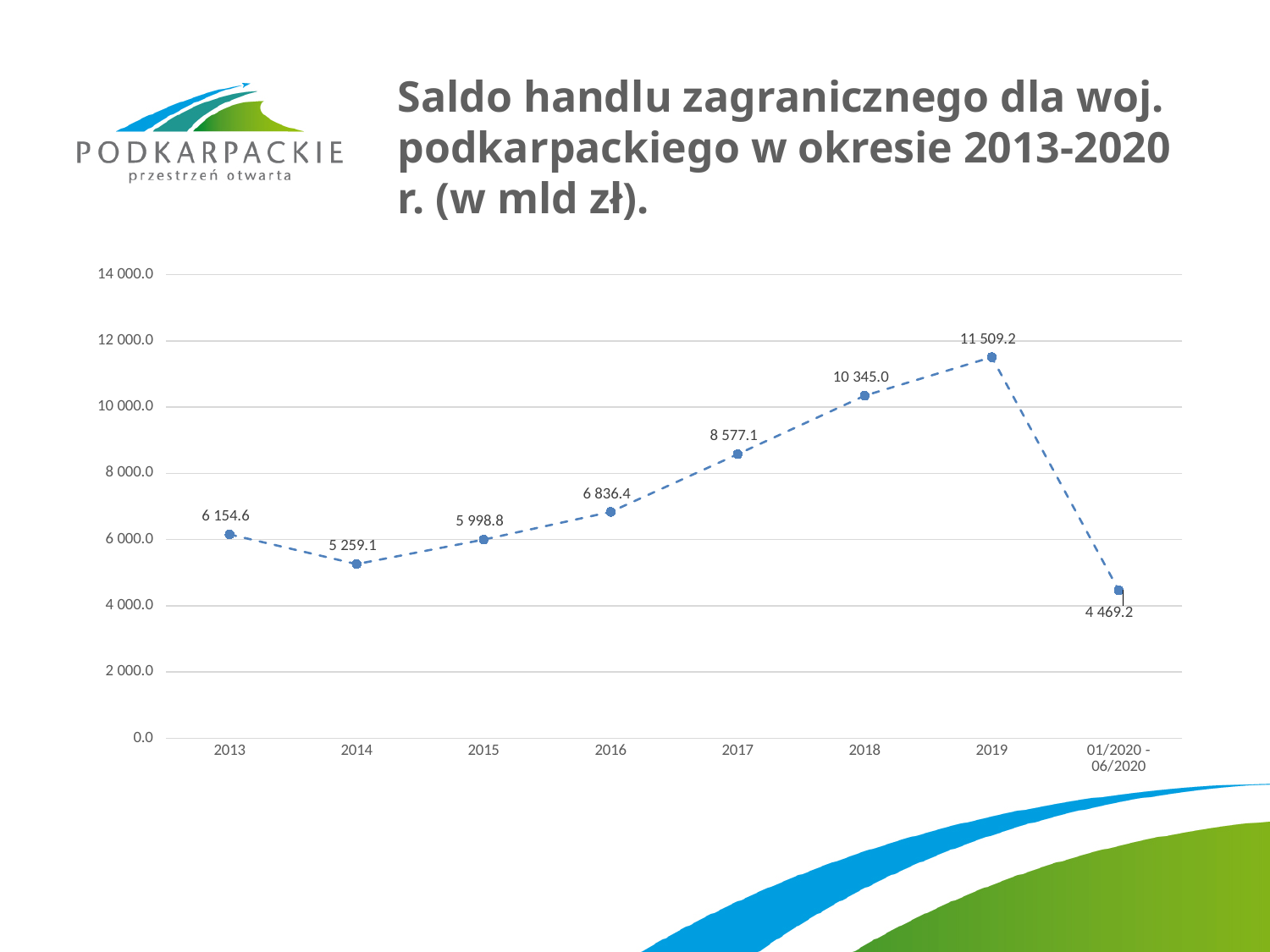
What is the value for 2018? 10 345.0 What kind of chart is shown on the slide? line chart What is the value for the period 01/2020 - 06/2020? 4 469.2 Which category has the highest value? 2019 How many data points are plotted on the chart? 8 What is the difference between the values for 2019 and 2018? 1 164.2 Which is larger, the value for 2014 or the value for 2015? 2015 Is the value for 2017 greater or less than 8 000.0? greater What is the difference between the values for 2017 and 2016? 1 740.7 What is the value for 2013? 6 154.6 Do the values rise or fall from 2014 to 2019? rise Which category has the lowest value? 01/2020 - 06/2020